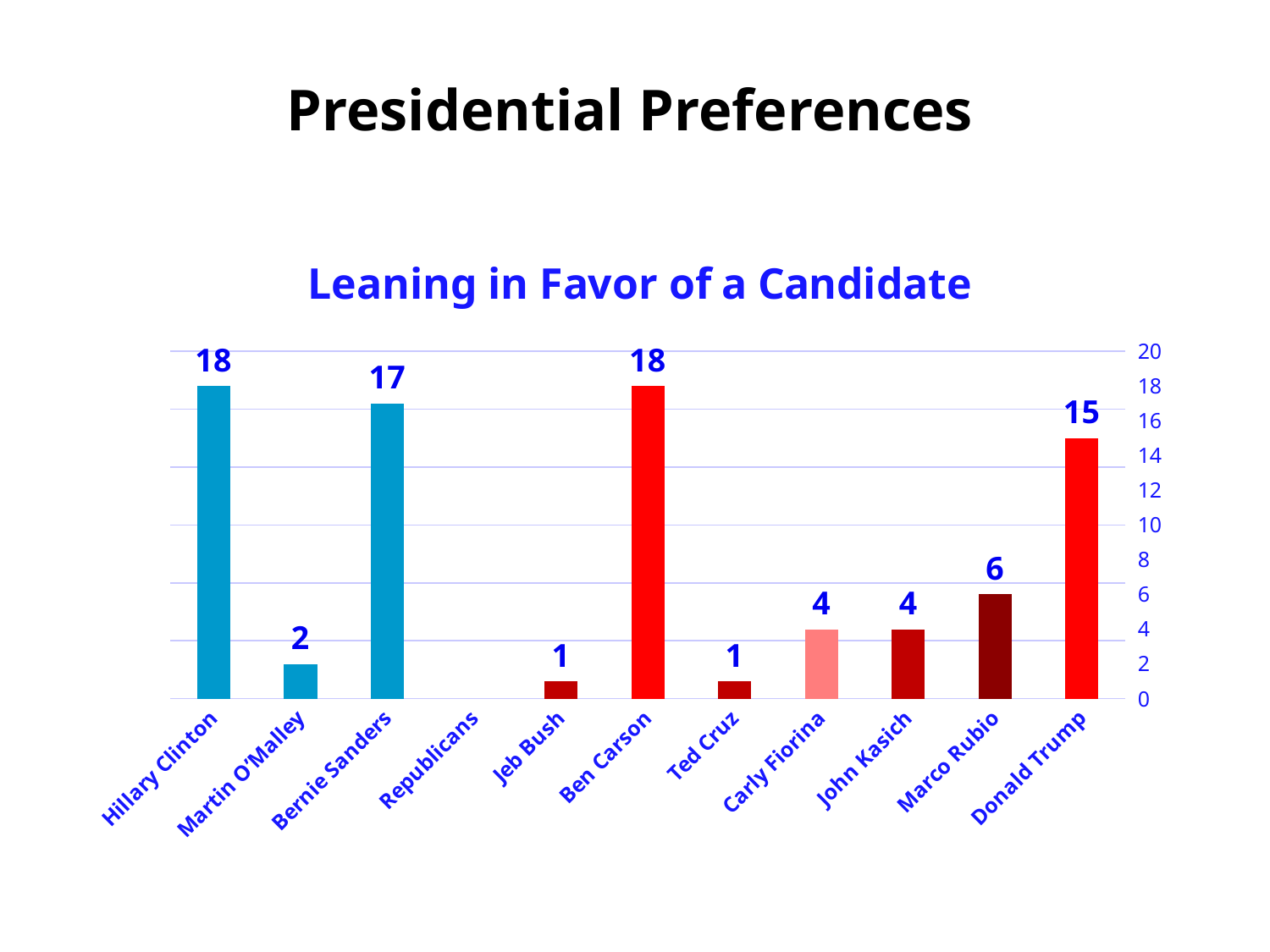
What is the value for Donald Trump? 15 What is the value for Hillary Clinton? 18 What is the value for Bernie Sanders? 17 Which is larger, the value for Bernie Sanders or the value for Donald Trump? Bernie Sanders What is the difference between the values for Hillary Clinton and Bernie Sanders? 1 How many bars are plotted in the chart? 10 What is the difference between the values for Ben Carson and Donald Trump? 3 What is the value for Martin O'Malley? 2 What kind of chart is shown on the slide? Bar chart What is the value for Marco Rubio? 6 Which is larger, the value for Marco Rubio or the value for John Kasich? Marco Rubio What is the title of the chart? Leaning in Favor of a Candidate